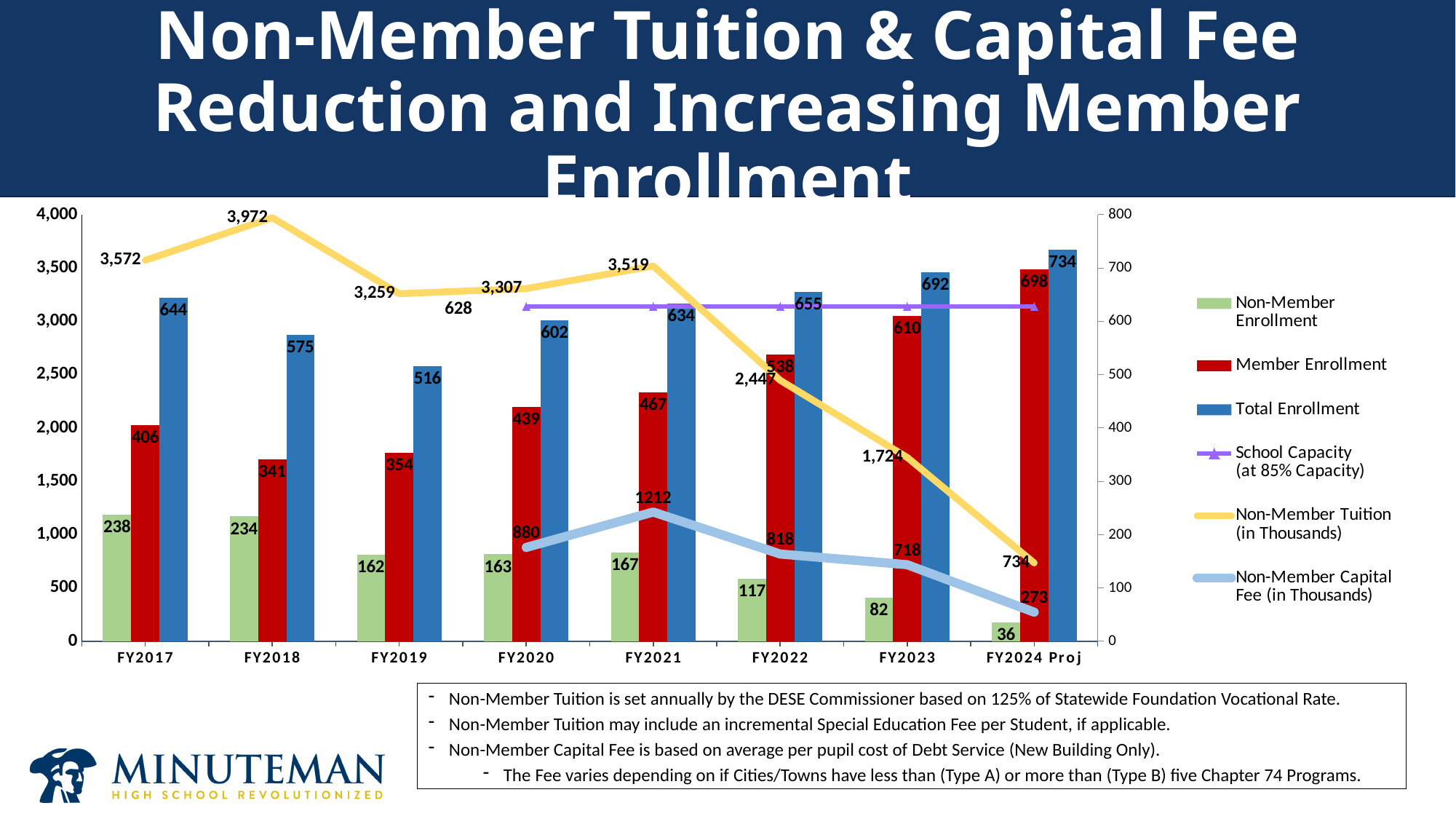
What is the Non-Member Tuition (in Thousands) value for FY2018? 3,972 What is the Non-Member Capital Fee (in Thousands) value for FY2021? 1212 What kind of chart is used for the enrollment series? Bar chart How many fiscal years are shown on the x axis? 8 What value is shown for School Capacity (at 85% Capacity)? 628 Which fiscal year has the lowest Non-Member Enrollment? FY2024 Proj Which fiscal year has the highest Total Enrollment? FY2024 Proj Does Non-Member Enrollment rise or fall from FY2021 to FY2024 Proj? Fall Which is larger, Non-Member Tuition (in Thousands) in FY2020 or in FY2022? FY2020 What is the Member Enrollment value for FY2021? 467 How many series does the legend list? 6 What is the difference between Member Enrollment in FY2024 Proj and FY2017? 292